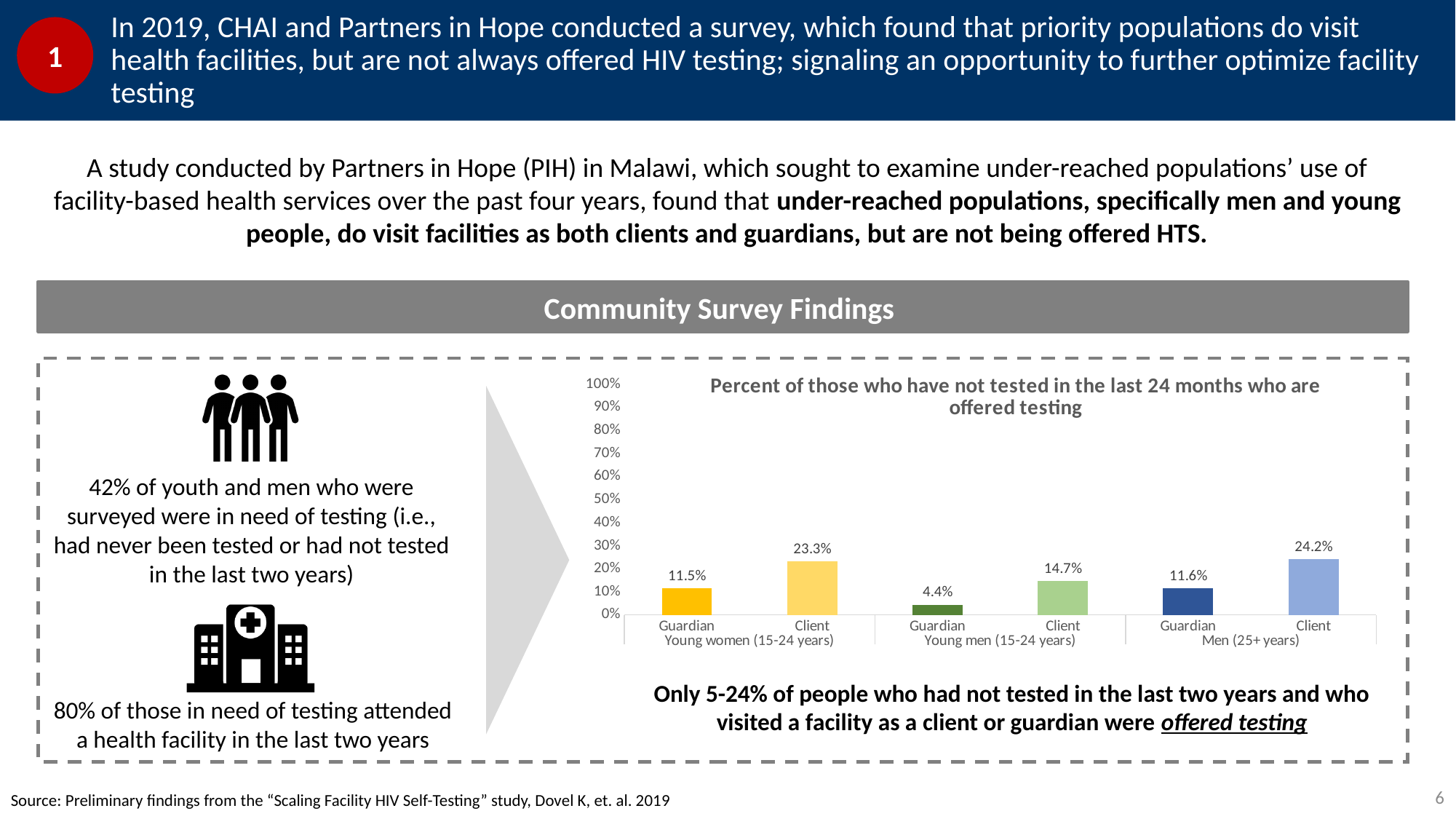
What is the value for Client among Young women (15-24 years)? 23.3% How many bars are plotted in the chart? 6 What is the value for Guardian among Men (25+ years)? 11.6% Which is larger: the Client value for Young men (15-24 years) or the Client value for Men (25+ years)? Client, Men (25+ years) What is the difference between the Client and Guardian values for Young women (15-24 years)? 11.8 percentage points Which bar has the highest value in the chart? Client, Men (25+ years) What is the value for Client among Men (25+ years)? 24.2% What type of chart is shown on the slide? Bar chart What is the difference between the Client and Guardian values for Young men (15-24 years)? 10.3 percentage points Is the value for Guardian among Young men (15-24 years) greater or less than 10%? less Which bar has the lowest value in the chart? Guardian, Young men (15-24 years) What is the value for Guardian among Young men (15-24 years)? 4.4%